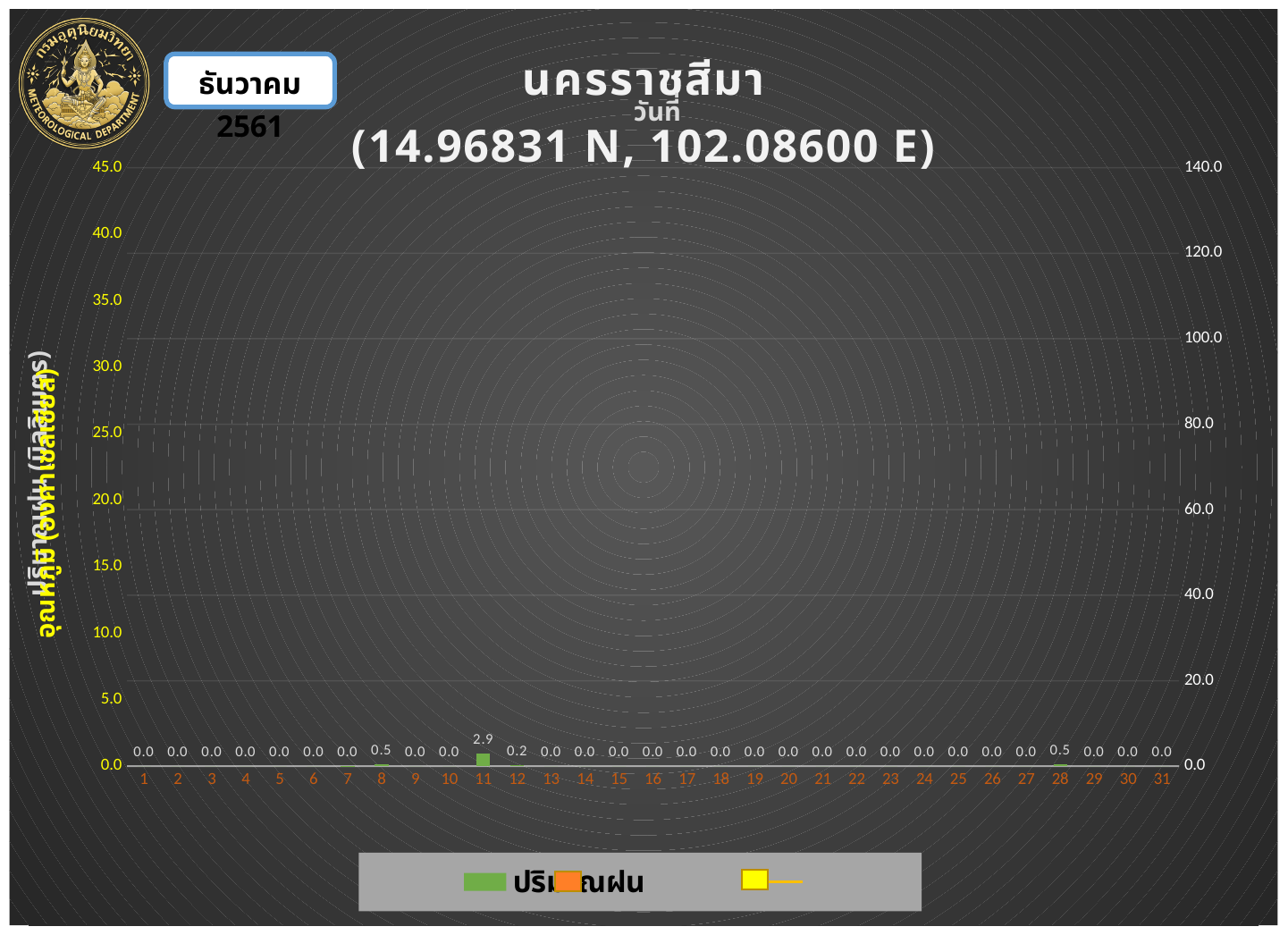
What is the rainfall value shown for day 28? 0.5 Which is larger, the rainfall value for day 11 or for day 8? Day 11 What is the highest tick value on the right-hand axis? 140.0 What is the rainfall value shown for day 20? 0.0 What is the difference between the rainfall values for day 11 and day 12? 2.7 What is the rainfall value shown for day 12? 0.2 Is the rainfall value for day 11 greater or less than 5.0 on the left axis? less What is the highest tick value on the left-hand axis? 45.0 Which day has the highest rainfall value? 11 What is the rainfall value shown for day 8? 0.5 How many days are shown on the x axis? 31 What is the rainfall value shown for day 11? 2.9